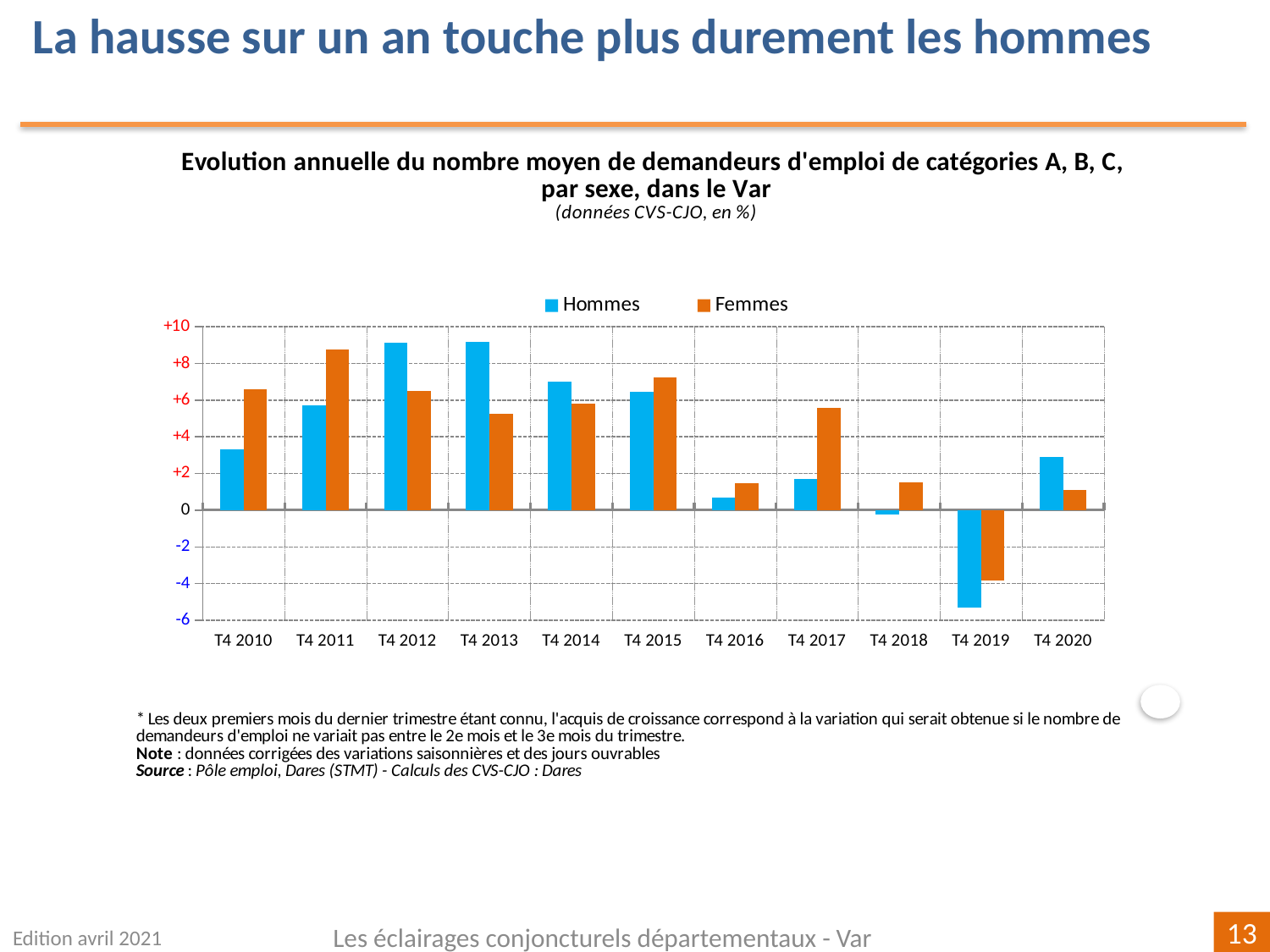
Is the value for Femmes in T4 2017 greater or less than +4? greater Which quarter has the lowest value for Hommes? T4 2019 In T4 2017, which series has the larger value, Hommes or Femmes? Femmes In which unit are the data expressed according to the chart subtitle? en % Which quarter has the highest value for Femmes? T4 2011 What kind of chart is shown on the slide? Bar chart Which colour represents the Femmes series in the legend? Orange Is the value for Hommes in T4 2019 greater or less than -4? less In T4 2020, which series has the larger value, Hommes or Femmes? Hommes Is the value for Femmes in T4 2011 greater or less than +8? greater How many quarters (categories) are shown on the x axis? 11 How many series does the legend list? 2